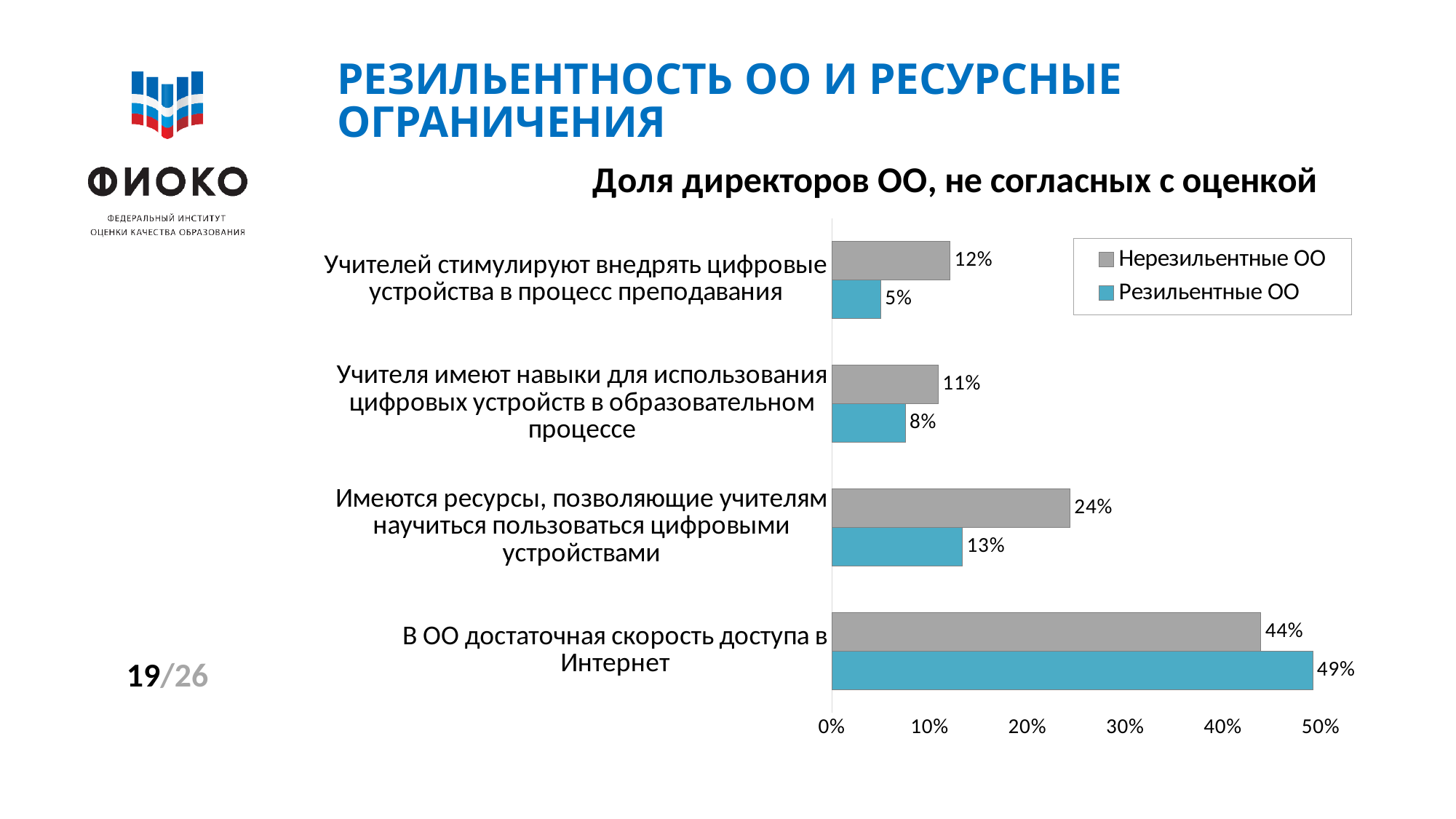
What is the value for 'Резильентные ОО' in the category 'Учителей стимулируют внедрять цифровые устройства в процесс преподавания'? 5% In the category 'В ОО достаточная скорость доступа в Интернет', which series has the larger value? Резильентные ОО How many categories are shown in the chart? 4 What type of chart is shown on the slide? Bar chart What is the value for 'Нерезильентные ОО' in the category 'В ОО достаточная скорость доступа в Интернет'? 44% How many series does the legend list? 2 Which category has the highest value for 'Резильентные ОО'? В ОО достаточная скорость доступа в Интернет Is the value for 'Нерезильентные ОО' in the category 'В ОО достаточная скорость доступа в Интернет' greater or less than 40%? greater What is the difference between 'Нерезильентные ОО' and 'Резильентные ОО' in the category 'Имеются ресурсы, позволяющие учителям научиться пользоваться цифровыми устройствами'? 11% What is the title of the chart? Доля директоров ОО, не согласных с оценкой Which category has the lowest value for 'Резильентные ОО'? Учителей стимулируют внедрять цифровые устройства в процесс преподавания What is the value for 'Резильентные ОО' in the category 'Имеются ресурсы, позволяющие учителям научиться пользоваться цифровыми устройствами'? 13%